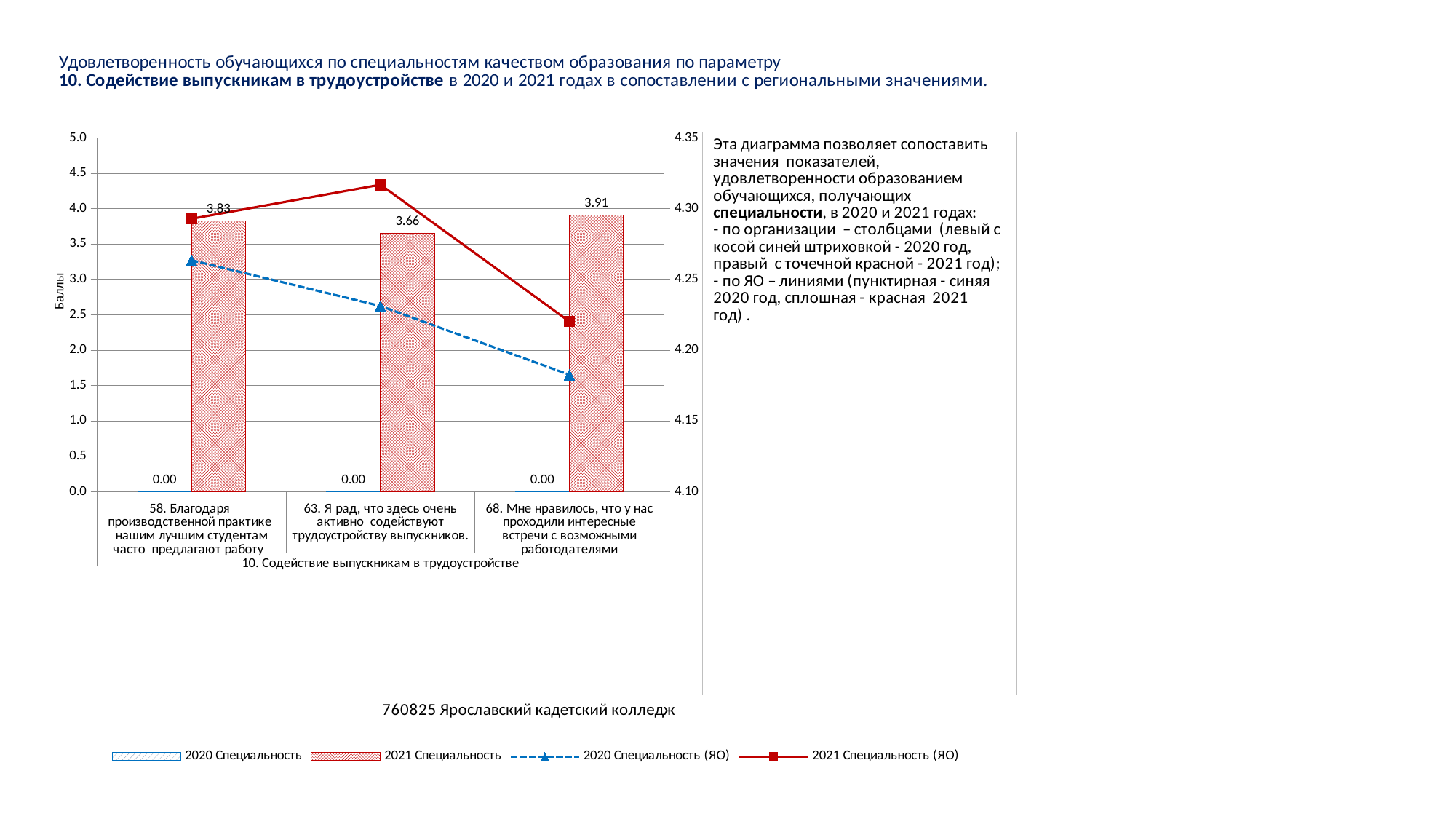
Which has a larger 2021 Специальность value: question 58 or question 63? Question 58 What is the value of the 2021 Специальность bar for question 58 (Благодаря производственной практике нашим лучшим студентам часто предлагают работу)? 3.83 Is the 2021 Специальность (ЯО) line value for question 63 greater or less than 4.30 on the right axis? greater How many series does the legend list? 4 What is the value of the 2021 Специальность bar for question 68 (Мне нравилось, что у нас проходили интересные встречи с возможными работодателями)? 3.91 Which question has the lowest 2021 Специальность bar? 63. Я рад, что здесь очень активно содействуют трудоустройству выпускников Which question has the highest 2021 Специальность bar? 68. Мне нравилось, что у нас проходили интересные встречи с возможными работодателями What is the difference between the 2021 Специальность values for question 68 and question 63? 0.25 How many questions (categories) are shown on the x axis? 3 What is the value of the 2021 Специальность bar for question 63 (Я рад, что здесь очень активно содействуют трудоустройству выпускников)? 3.66 What value is labelled for the 2020 Специальность series for question 58? 0.00 Does the 2020 Специальность (ЯО) dashed line rise or fall from left to right across the categories? falls